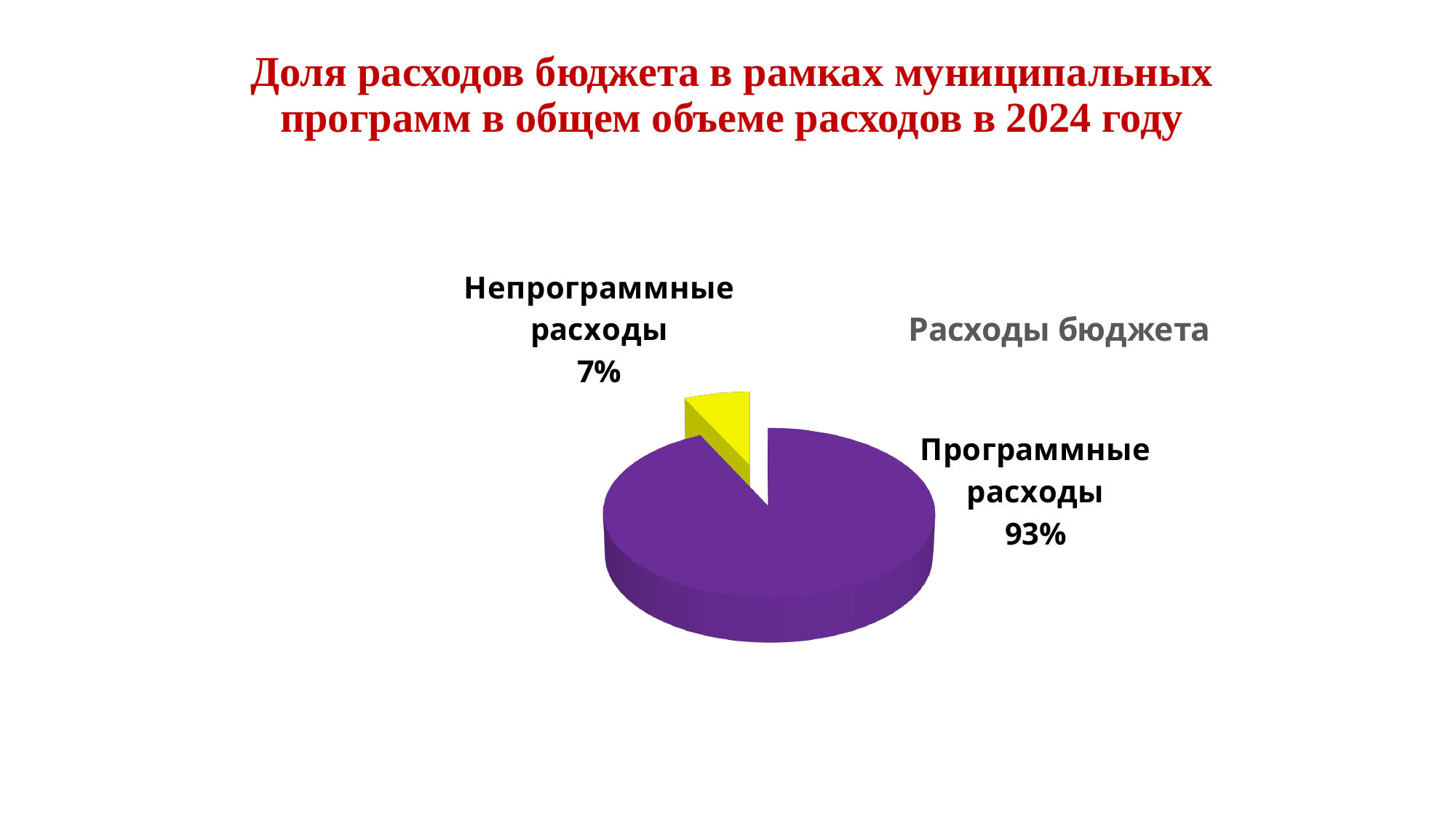
What share of the pie is labelled "Непрограммные расходы"? 7% What is the total of the two slices shown in the pie chart? 100% Which slice of the pie is the smallest? Непрограммные расходы What colour is the "Непрограммные расходы" slice? Yellow Which is larger: "Программные расходы" or "Непрограммные расходы"? Программные расходы What is the title of the chart? Расходы бюджета Which slice of the pie is the largest? Программные расходы How many slices does the pie chart have? 2 What share of the pie is labelled "Программные расходы"? 93% What kind of chart is shown on the slide? Pie chart What is the difference in percentage points between "Программные расходы" and "Непрограммные расходы"? 86